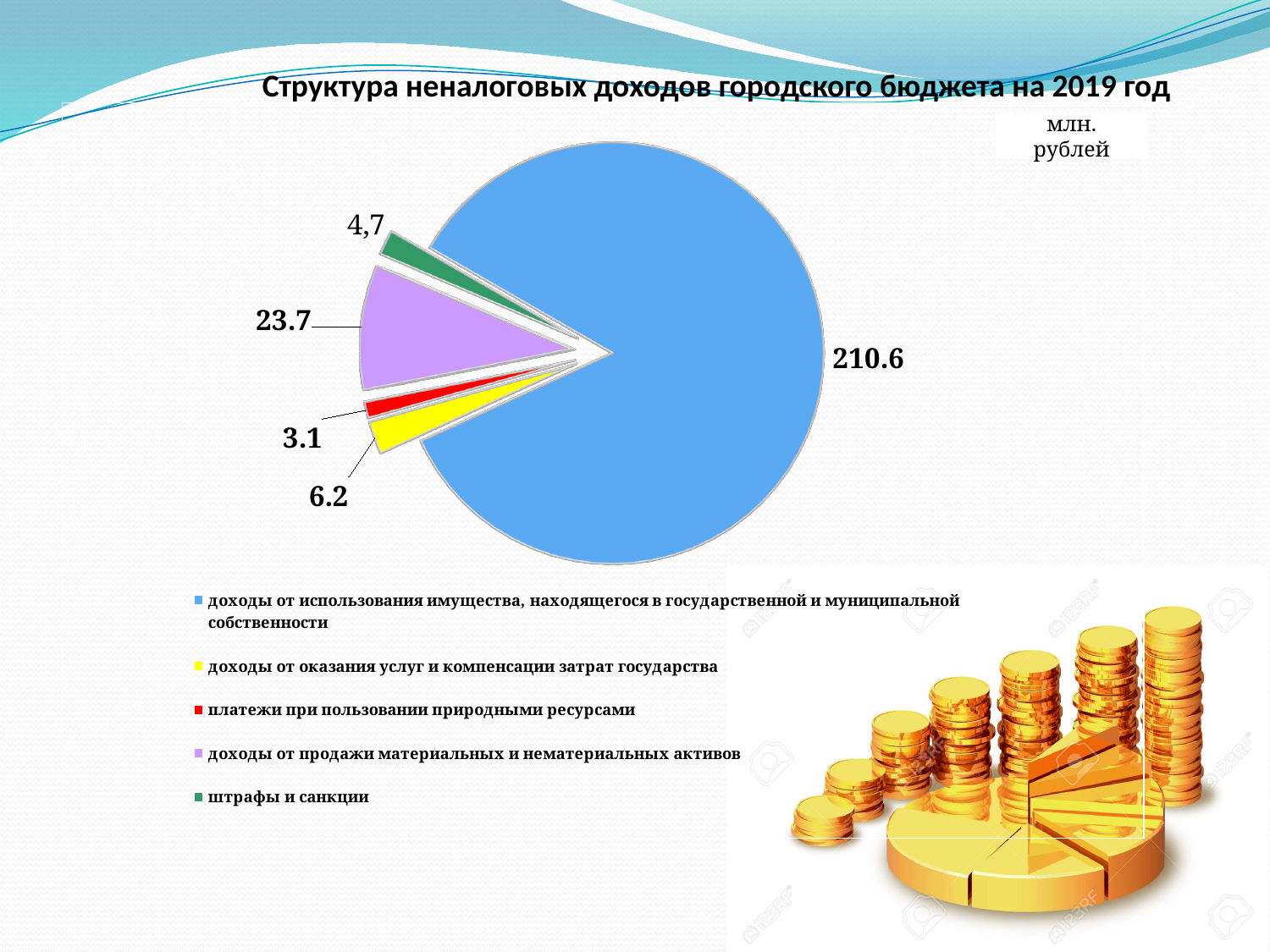
What is the value for «доходы от оказания услуг и компенсации затрат государства»? 6.2 What is the value for «штрафы и санкции»? 4,7 How many categories does the pie chart have? 5 Which category has the largest slice of the pie? доходы от использования имущества, находящегося в государственной и муниципальной собственности What unit is indicated for the values in the chart? млн. рублей What is the value for «доходы от использования имущества, находящегося в государственной и муниципальной собственности»? 210.6 What is the value for «доходы от продажи материальных и нематериальных активов»? 23.7 Which category has the smallest slice of the pie? платежи при пользовании природными ресурсами Which is larger: the value for «штрафы и санкции» or the value for «платежи при пользовании природными ресурсами»? штрафы и санкции What is the value for «платежи при пользовании природными ресурсами»? 3.1 What is the difference between the value for «доходы от продажи материальных и нематериальных активов» and the value for «доходы от оказания услуг и компенсации затрат государства»? 17.5 What kind of chart is shown on the slide? pie chart